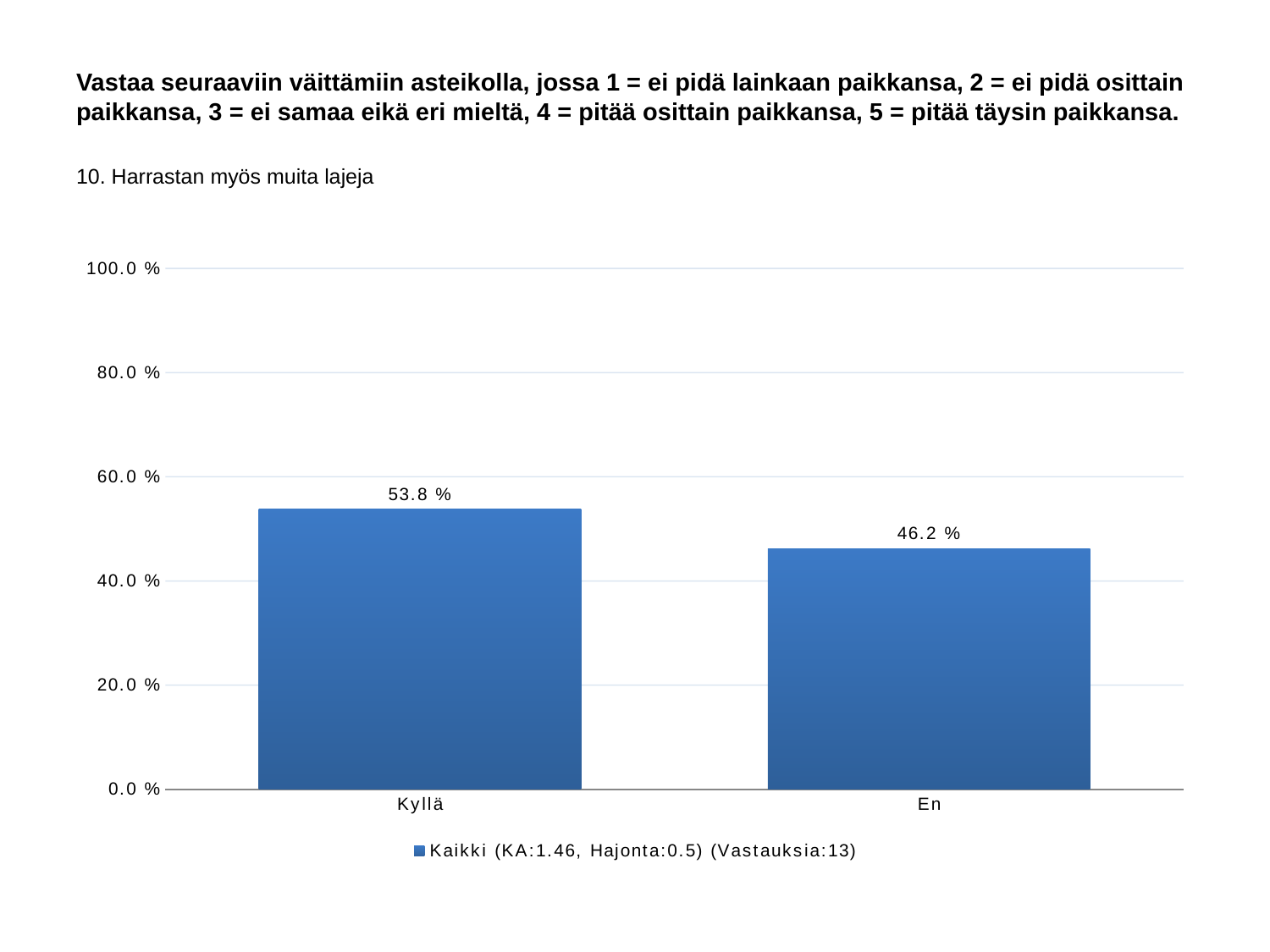
Is the value for En greater or less than 60.0 %? less Which is larger, the value for Kyllä or the value for En? Kyllä What kind of chart is shown on the slide? bar chart Is the value for Kyllä greater or less than 40.0 %? greater How many series does the legend list? 1 What is the difference between the values for Kyllä and En? 7.6 % Which category has the highest value? Kyllä What is the value for En? 46.2 % Which category has the lowest value? En How many categories are shown on the x axis? 2 What is the value for Kyllä? 53.8 % How many responses (Vastauksia) does the legend entry report? 13